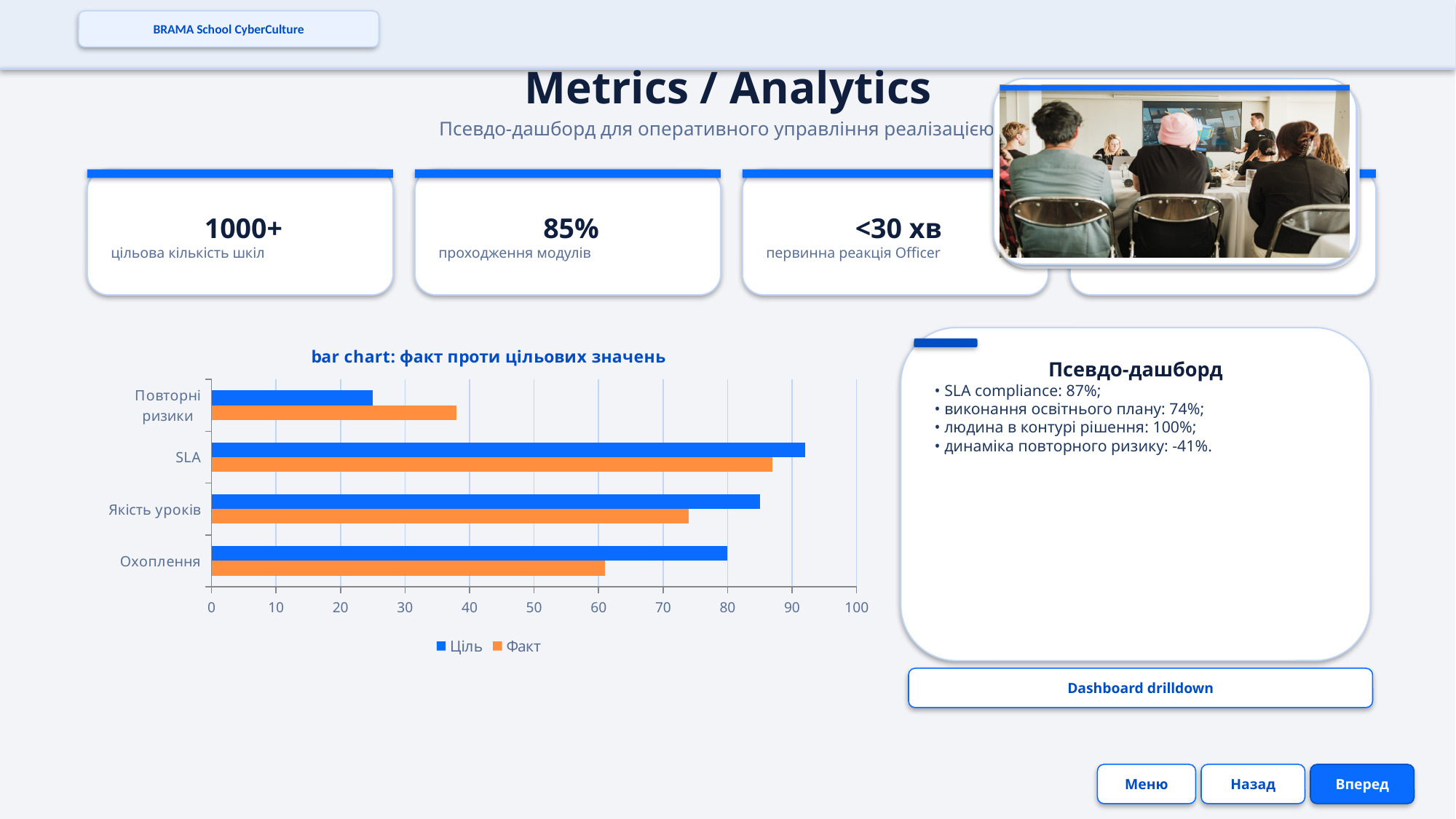
Which category has the highest Факт value? SLA Is the Ціль value for SLA greater or less than 90? greater Which category has the highest Ціль value? SLA Which category has the lowest Факт value? Повторні ризики How many series does the chart legend list? 2 Is the Факт value for Охоплення greater or less than 70? less For Охоплення, which is larger: Ціль or Факт? Ціль What kind of chart is shown on the slide? bar chart For Повторні ризики, which is larger: Ціль or Факт? Факт What are the two series names shown in the chart legend? Ціль and Факт Which category has the lowest Ціль value? Повторні ризики How many categories are plotted on the chart? 4